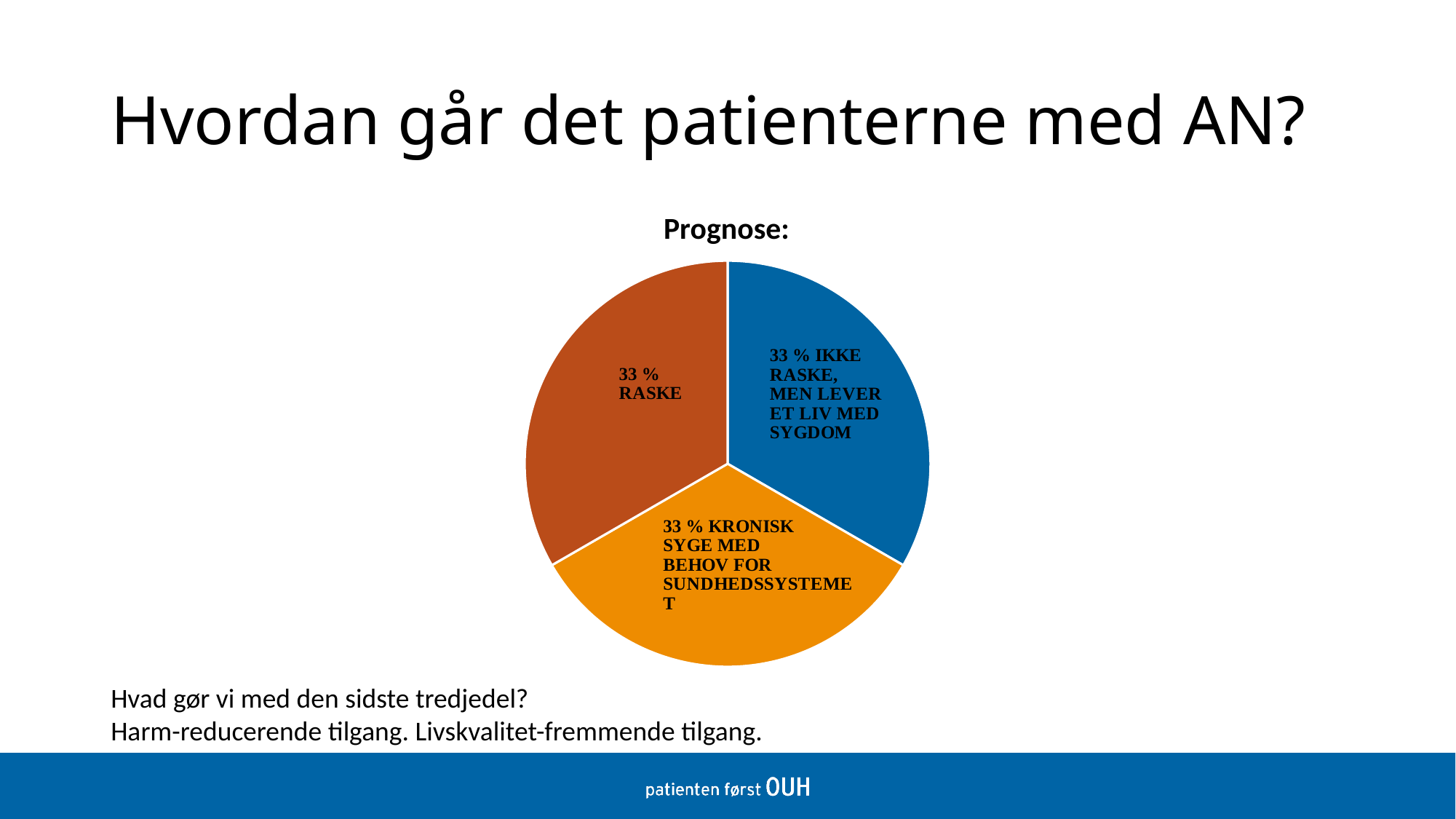
What is the difference between the RASKE slice and the KRONISK SYGE slice? 0 What share of the pie is labelled RASKE? 33 % How many slices does the pie chart have? 3 Is the share for RASKE greater or less than 50%? less What kind of chart is shown on the slide? pie chart What percentage is shown for the slice 'KRONISK SYGE MED BEHOV FOR SUNDHEDSSYSTEMET'? 33 % What colour is the slice labelled RASKE? brown What percentage is shown for the slice 'IKKE RASKE, MEN LEVER ET LIV MED SYGDOM'? 33 % What is the title of the pie chart? Prognose: